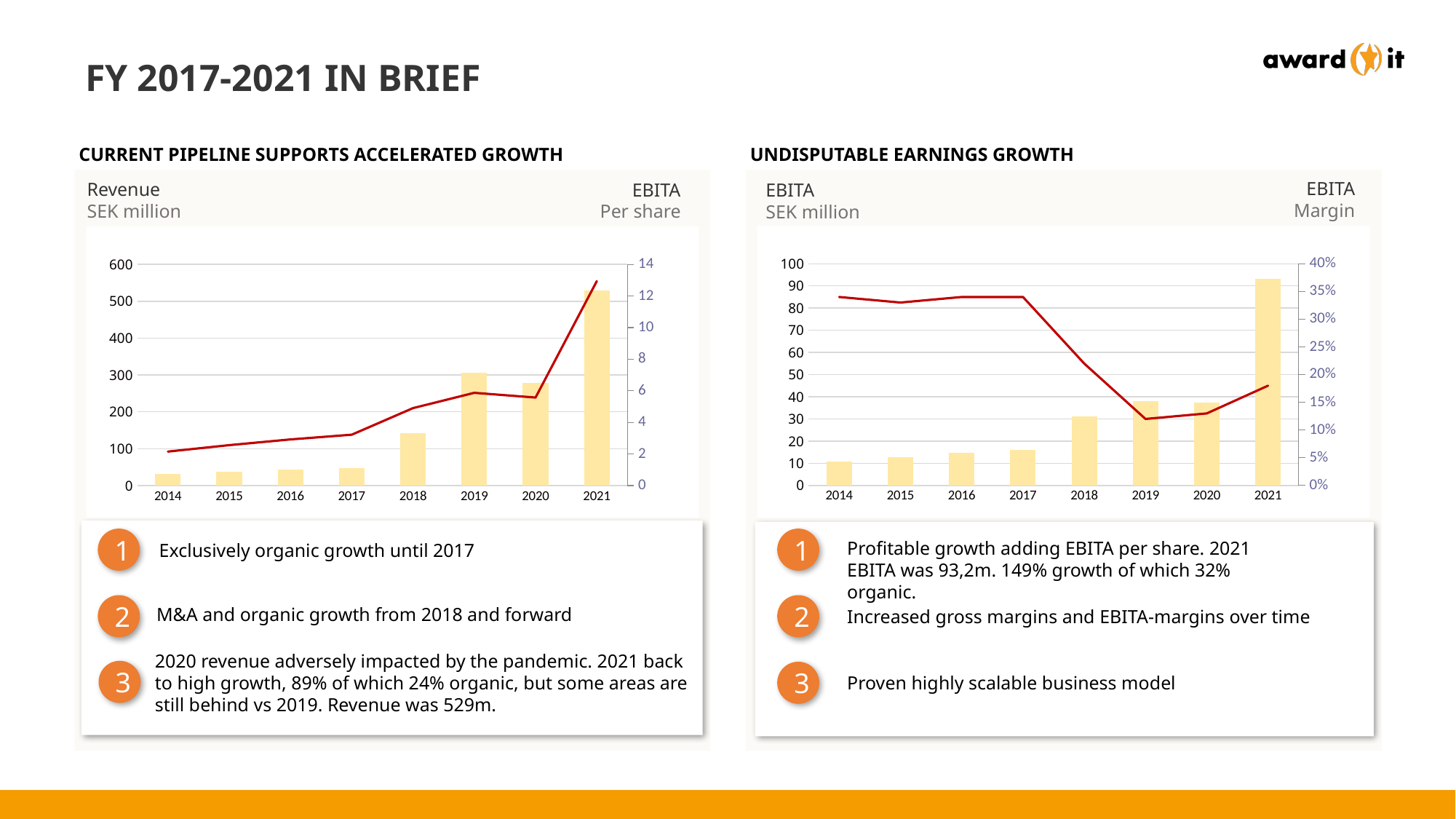
On the left chart (Revenue / EBITA per share), which year has the highest revenue bar? 2021 On the left chart (Revenue / EBITA per share), is the revenue bar for 2021 greater or less than 500? greater On the left chart (Revenue / EBITA per share), is the revenue bar for 2017 greater or less than 100? less On the right chart (EBITA / EBITA Margin), which year has the highest EBITA bar? 2021 On the right chart (EBITA / EBITA Margin), in which year is the EBITA margin line at its lowest point? 2019 What kind of chart is the left chart showing Revenue and EBITA per share? A combined bar and line chart On the left chart (Revenue / EBITA per share), which year has a higher revenue bar, 2018 or 2019? 2019 On the left chart (Revenue / EBITA per share), which year has the lowest revenue bar? 2014 On the left chart (Revenue / EBITA per share), what is the unit shown for the revenue axis? SEK million On the right chart (EBITA / EBITA Margin), is the EBITA bar for 2021 greater or less than 80? greater On the left chart (Revenue / EBITA per share), how many years are shown on the x axis? 8